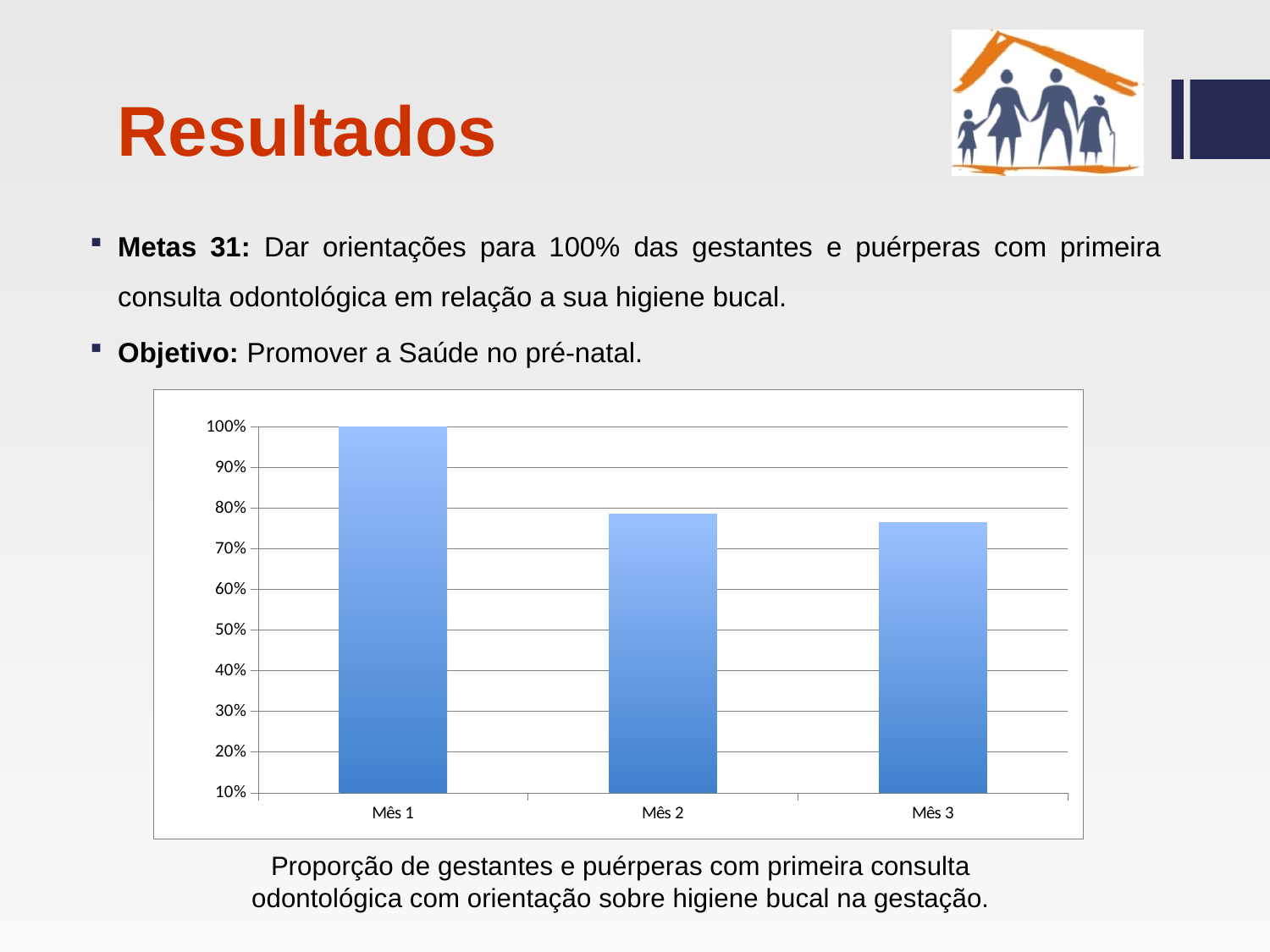
Which month has the highest value? Mês 1 Which is larger, the value for Mês 1 or the value for Mês 2? Mês 1 What is the highest value shown on the vertical axis? 100% What is the value for Mês 1? 100% Is the value for Mês 2 greater or less than 90%? less Is the value for Mês 2 greater or less than 70%? greater How many months are shown on the x axis? 3 Do the values rise or fall from Mês 1 to Mês 3? fall What kind of chart is shown on the slide? bar chart Which is larger, the value for Mês 1 or the value for Mês 3? Mês 1 Is the value for Mês 3 greater or less than 80%? less